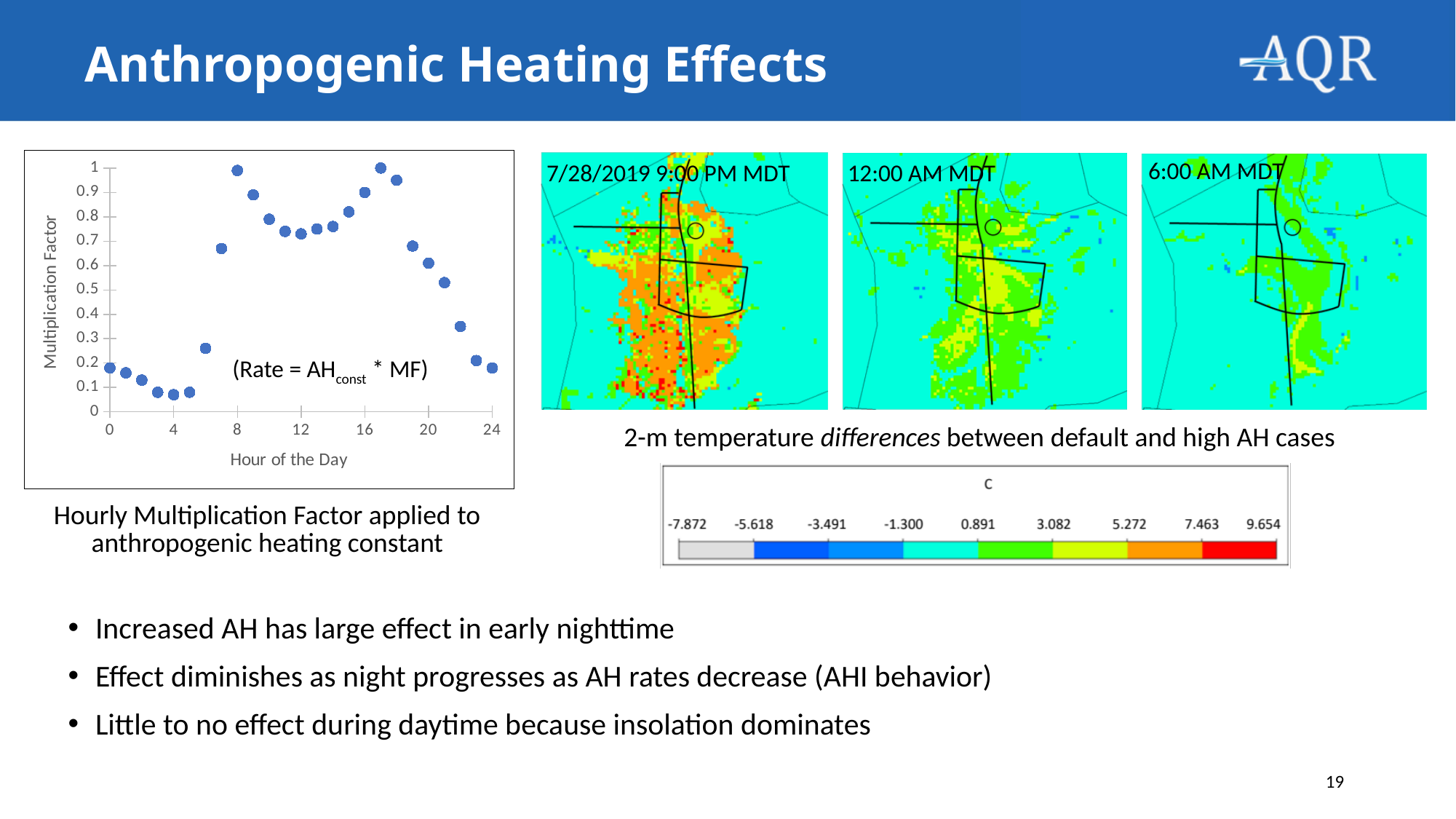
In the left chart, which has the larger multiplication factor, hour 6 or hour 7? Hour 7 In the left chart, how many data points are plotted? 25 In the left chart, what is the label of the x axis? Hour of the Day In the left chart, what is the label of the y axis? Multiplication Factor In the left chart, is the multiplication factor at hour 4 greater or less than 0.1? less In the left chart, is the multiplication factor at hour 12 greater or less than 0.8? less In the left chart, do the multiplication factor values rise or fall from hour 17 to hour 24? Fall In the left chart, which has the larger multiplication factor, hour 4 or hour 8? Hour 8 In the left chart, is the multiplication factor at hour 0 greater or less than 0.1? greater What kind of chart is shown on the left of the slide? Scatter chart